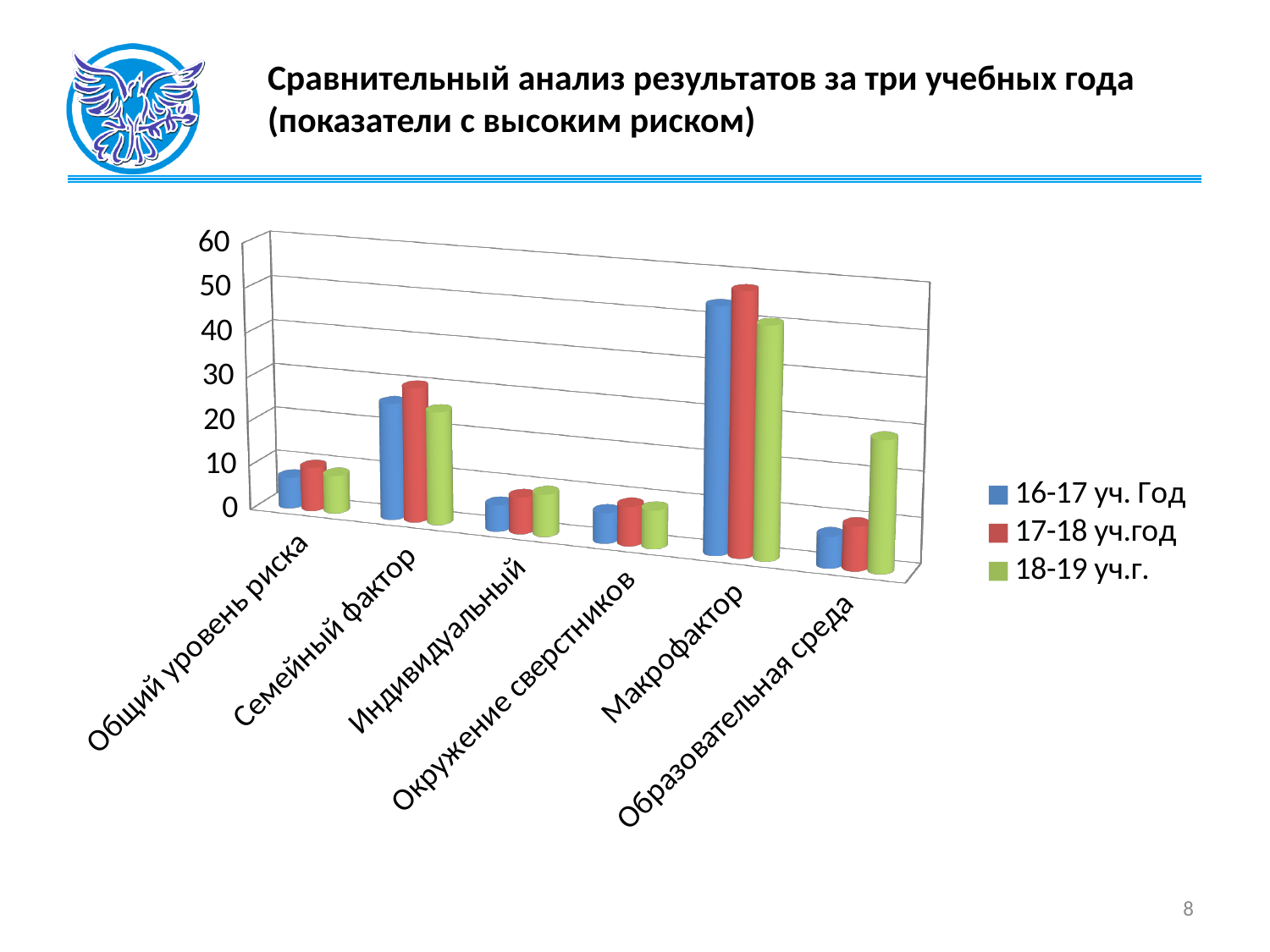
For Семейный фактор, which series has the highest bar? 17-18 уч.год How many series does the legend list? 3 Which category has the highest values in the chart? Макрофактор Is the value for Общий уровень риска in 16-17 уч. Год greater or less than 20? less For Макрофактор, which series has the highest bar? 17-18 уч.год What kind of chart is shown on the slide? bar chart What colour represents the series 18-19 уч.г. in the chart? green For Макрофактор, which is larger: the value for 17-18 уч.год or the value for 18-19 уч.г.? 17-18 уч.год How many categories are shown on the x axis of the chart? 6 Is the value for Макрофактор in 17-18 уч.год greater or less than 40? greater For Образовательная среда, which is larger: the value for 18-19 уч.г. or the value for 16-17 уч. Год? 18-19 уч.г. Is the value for Семейный фактор in 17-18 уч.год greater or less than 20? greater